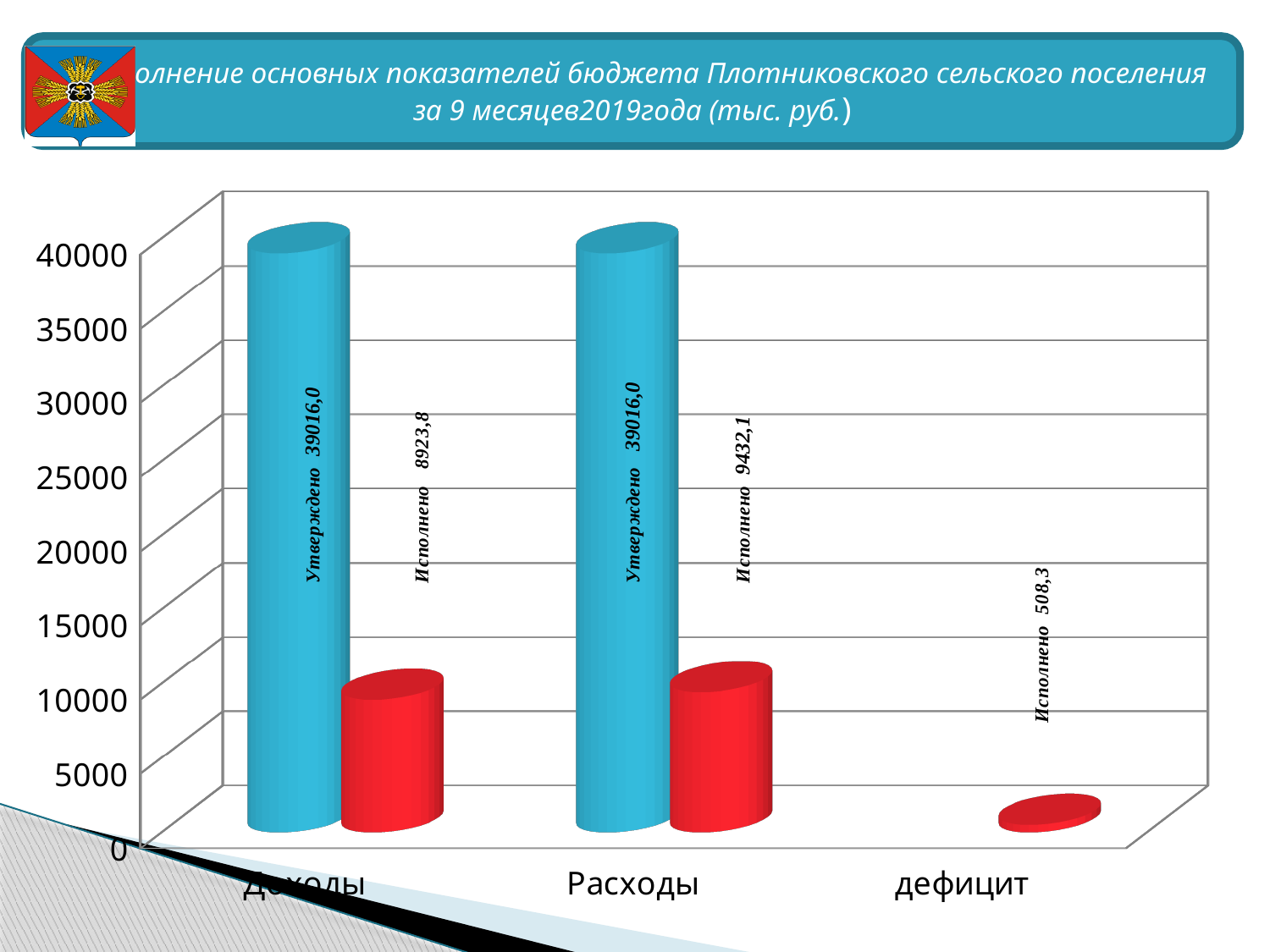
What is the Исполнено value for Доходы? 8923,8 Which category has the lowest Исполнено value? дефицит What is the Исполнено value for Расходы? 9432,1 What kind of chart is shown on the slide? bar chart Is the Утверждено value for Доходы greater or less than 35000? greater How many categories are shown on the x axis? 3 What is the Утверждено value for Расходы? 39016,0 Which has the larger Исполнено value, Доходы or Расходы? Расходы What is the Исполнено value for дефицит? 508,3 What is the difference between the Исполнено values for Расходы and Доходы? 508,3 For Доходы, how much larger is the Утверждено value than the Исполнено value? 30092,2 For Расходы, how much larger is the Утверждено value than the Исполнено value? 29583,9